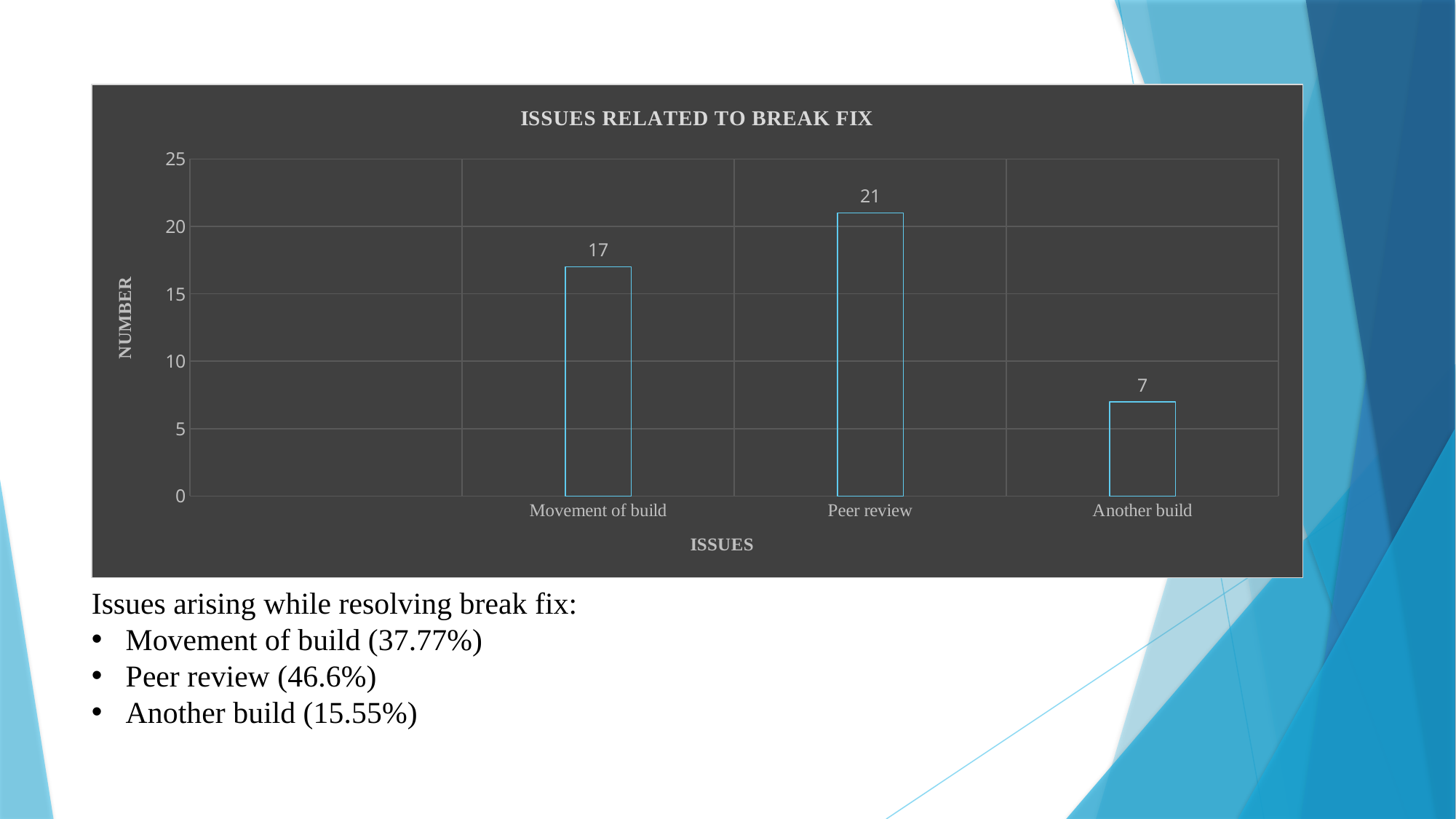
Is the value for Peer review greater or less than 20? greater What is the difference between the values for Peer review and Movement of build? 4 Which category has the lowest value? Another build What is the title of the chart? ISSUES RELATED TO BREAK FIX Which is larger, the value for Movement of build or the value for Another build? Movement of build What is the value for Peer review? 21 What is the value for Movement of build? 17 How many categories are shown on the x axis? 3 What is the difference between the values for Movement of build and Another build? 10 Which category has the highest value? Peer review What kind of chart is shown on the slide? bar chart What is the value for Another build? 7